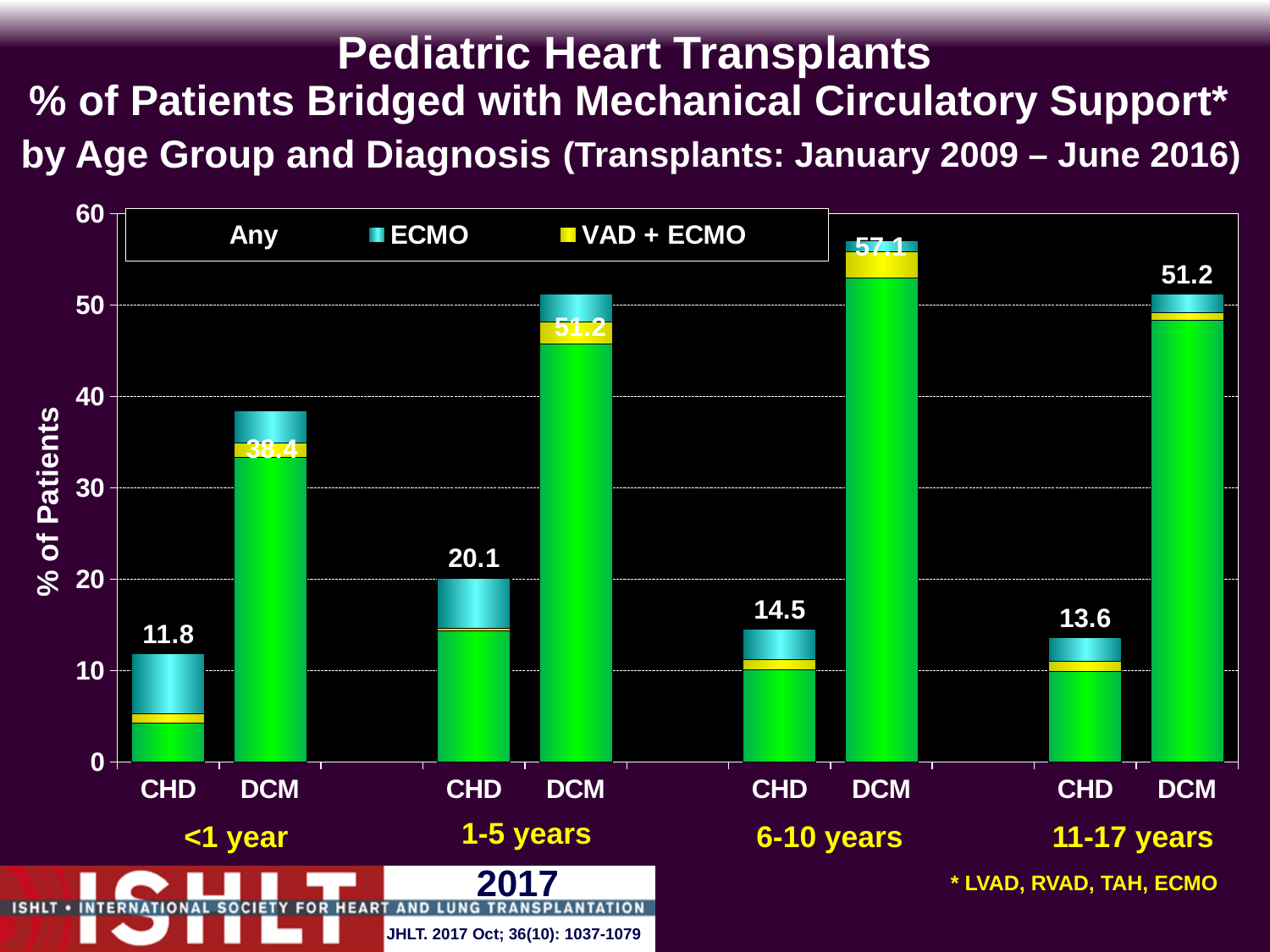
What is the difference between the DCM and CHD totals in the <1 year age group? 26.6 How many series does the legend list? 3 Which is larger, the total for CHD aged 6-10 years or CHD aged 11-17 years? CHD aged 6-10 years What is the total percentage for DCM patients aged 6-10 years? 57.1 What is the total percentage for CHD patients aged 1-5 years? 20.1 Which bar has the lowest total percentage? CHD, <1 year Which bar has the highest total percentage? DCM, 6-10 years What type of chart is shown on the slide? Stacked bar chart Is the total for DCM patients aged 1-5 years greater or less than 50? greater How many bars are plotted on the chart? 8 What is the total percentage of patients bridged with mechanical circulatory support for CHD patients under 1 year? 11.8 What is the total percentage for DCM patients aged 11-17 years? 51.2